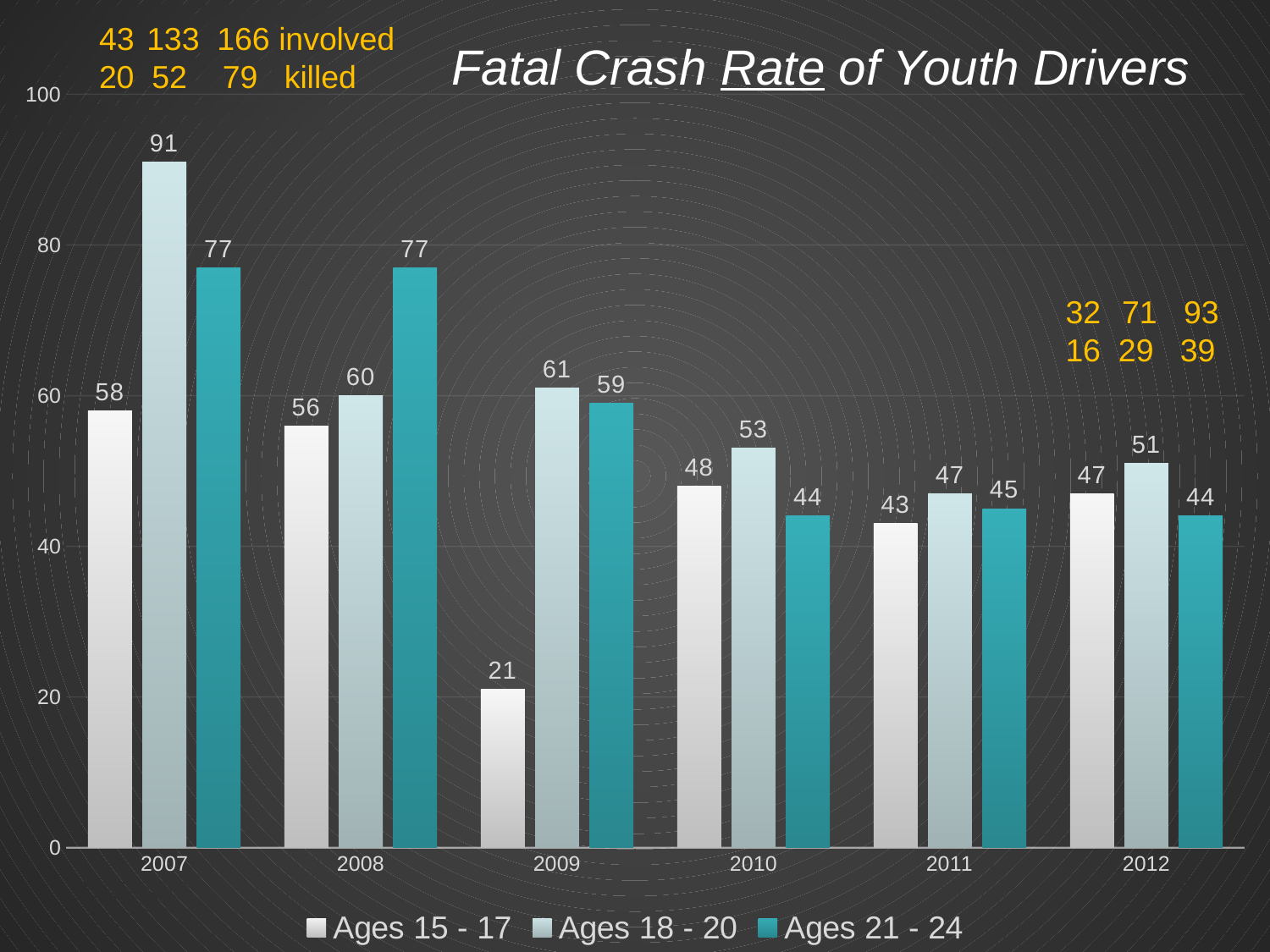
How many years are shown on the x axis? 6 How many series does the legend list? 3 What is the value for Ages 18 - 20 in 2007? 91 What is the value for Ages 15 - 17 in 2009? 21 Is the value for Ages 21 - 24 in 2008 greater or less than 60? greater Which is larger in 2010, the Ages 15 - 17 value or the Ages 21 - 24 value? Ages 15 - 17 What is the title of the chart? Fatal Crash Rate of Youth Drivers What kind of chart is shown on the slide? Bar chart In which year is the Ages 15 - 17 value lowest? 2009 What is the difference between the Ages 18 - 20 and Ages 15 - 17 values in 2009? 40 What is the value for Ages 21 - 24 in 2012? 44 In which year is the Ages 18 - 20 value highest? 2007